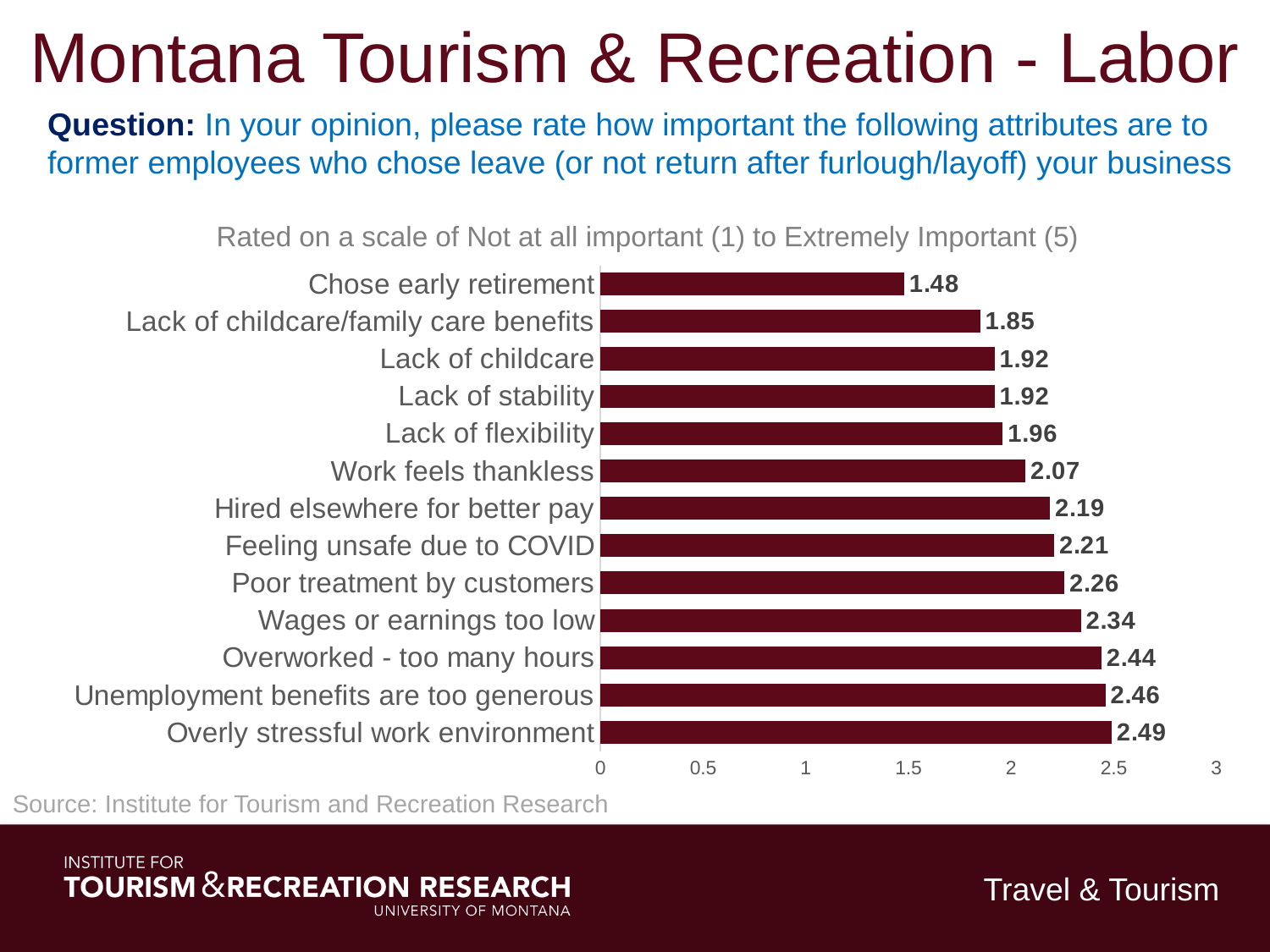
What is the rating for Overly stressful work environment? 2.49 What is the difference between the ratings for Overly stressful work environment and Chose early retirement? 1.01 Which attribute has the lowest rating? Chose early retirement What is the rating for Chose early retirement? 1.48 What is the difference between the ratings for Unemployment benefits are too generous and Overworked - too many hours? 0.02 What kind of chart is shown on the slide? Bar chart What is the title of the chart? Rated on a scale of Not at all important (1) to Extremely Important (5) Is the rating for Hired elsewhere for better pay greater or less than 2? greater Which has a higher rating: Work feels thankless or Lack of flexibility? Work feels thankless What is the rating for Wages or earnings too low? 2.34 How many attributes are shown in the chart? 13 Which attribute has the highest rating? Overly stressful work environment